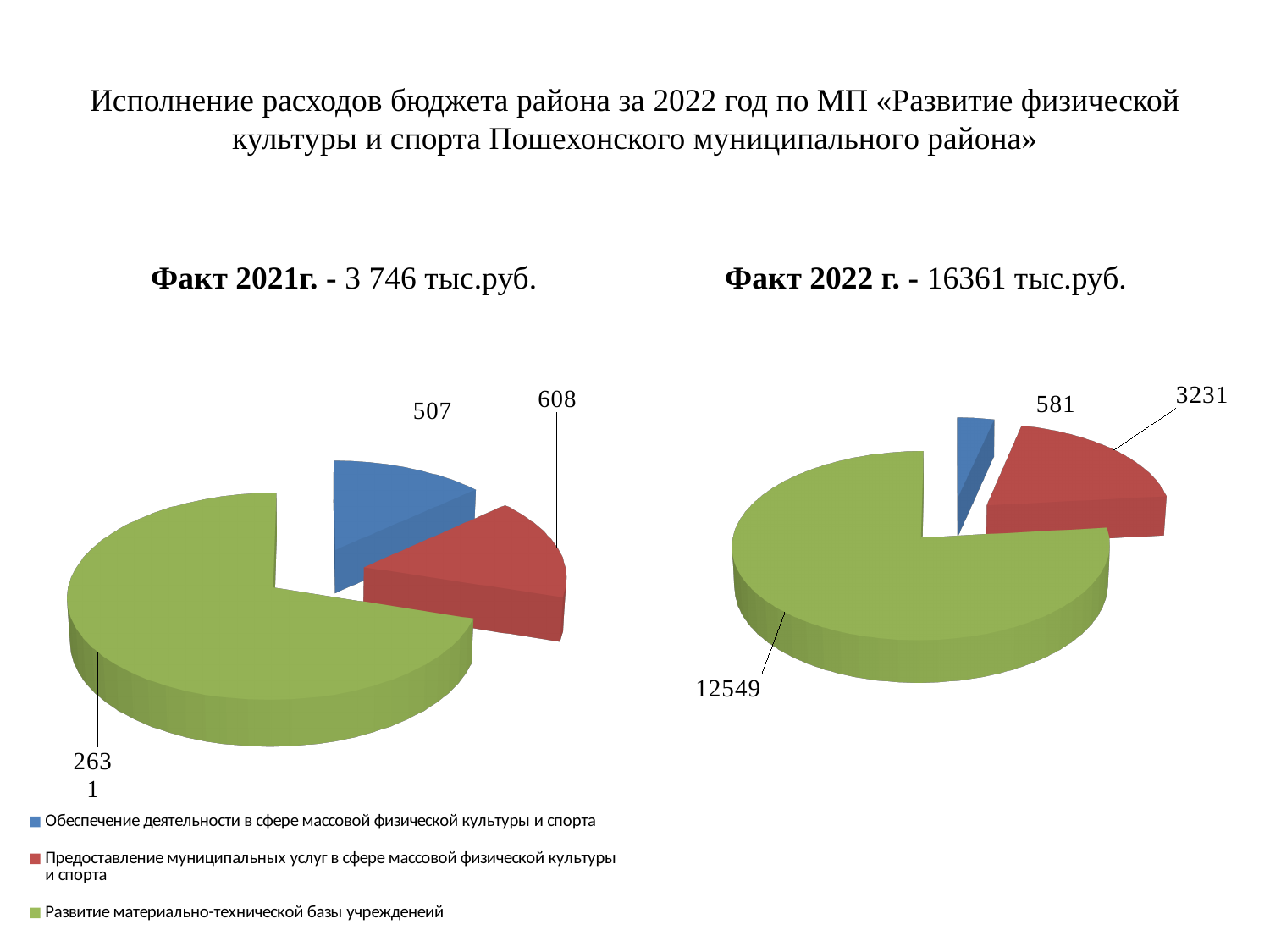
What type of chart is used on this slide? Pie chart In the right pie chart (Факт 2022 г.), what is the value for «Предоставление муниципальных услуг в сфере массовой физической культуры и спорта»? 3231 In the left pie chart (Факт 2021г.), what is the difference between the values 608 and 507? 101 In the left pie chart (Факт 2021г.), what is the value for «Обеспечение деятельности в сфере массовой физической культуры и спорта»? 507 In the right pie chart (Факт 2022 г.), which category has the largest slice? Развитие материально-технической базы учреждений In the right pie chart (Факт 2022 г.), what is the value for «Обеспечение деятельности в сфере массовой физической культуры и спорта»? 581 In the right pie chart (Факт 2022 г.), what is the difference between «Предоставление муниципальных услуг» (3231) and «Обеспечение деятельности» (581)? 2650 In the right pie chart (Факт 2022 г.), what is the value for «Развитие материально-технической базы учреждений»? 12549 In the left pie chart (Факт 2021г.), which is larger: «Обеспечение деятельности в сфере массовой физической культуры и спорта» or «Предоставление муниципальных услуг в сфере массовой физической культуры и спорта»? Предоставление муниципальных услуг в сфере массовой физической культуры и спорта In the right pie chart (Факт 2022 г.), which category has the smallest slice? Обеспечение деятельности в сфере массовой физической культуры и спорта In the left pie chart (Факт 2021г.), what is the value for «Предоставление муниципальных услуг в сфере массовой физической культуры и спорта»? 608 How many categories does the legend list? 3